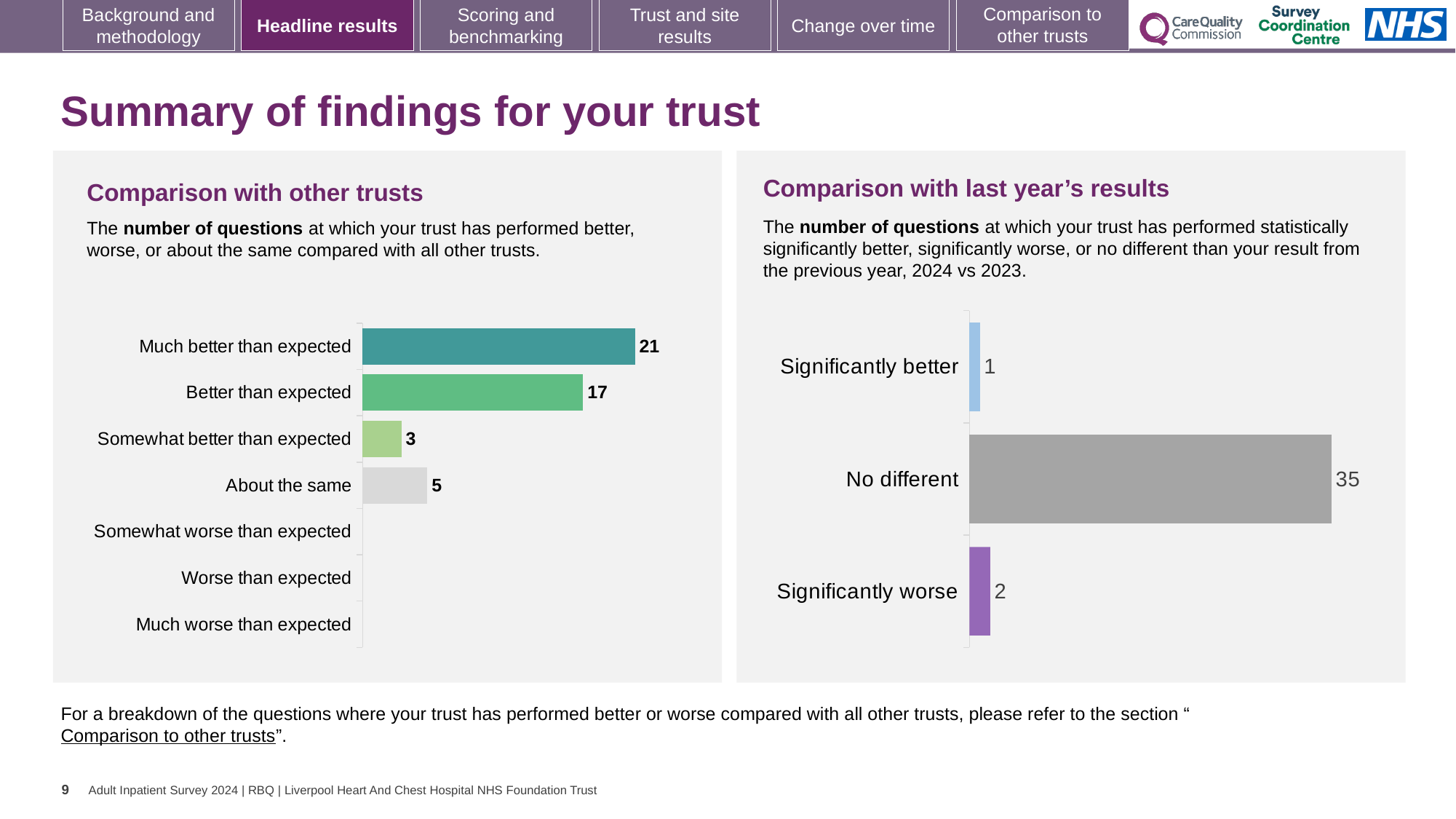
In the 'Comparison with last year's results' chart, which category has the lowest value? Significantly better In the 'Comparison with other trusts' chart, what is the value for 'Better than expected'? 17 In the 'Comparison with other trusts' chart, what is the difference between 'Much better than expected' and 'Better than expected'? 4 What type of chart is the 'Comparison with last year's results' chart? Bar chart In the 'Comparison with other trusts' chart, what is the value for 'About the same'? 5 In the 'Comparison with last year's results' chart, what is the difference between 'No different' and 'Significantly worse'? 33 In the 'Comparison with other trusts' chart, what is the value for 'Much better than expected'? 21 How many categories are listed on the y axis of the 'Comparison with other trusts' chart? 7 In the 'Comparison with last year's results' chart, what is the value for 'Significantly worse'? 2 In the 'Comparison with last year's results' chart, what is the value for 'No different'? 35 In the 'Comparison with other trusts' chart, which is larger: 'Somewhat better than expected' or 'About the same'? About the same In the 'Comparison with other trusts' chart, which category has the highest value? Much better than expected